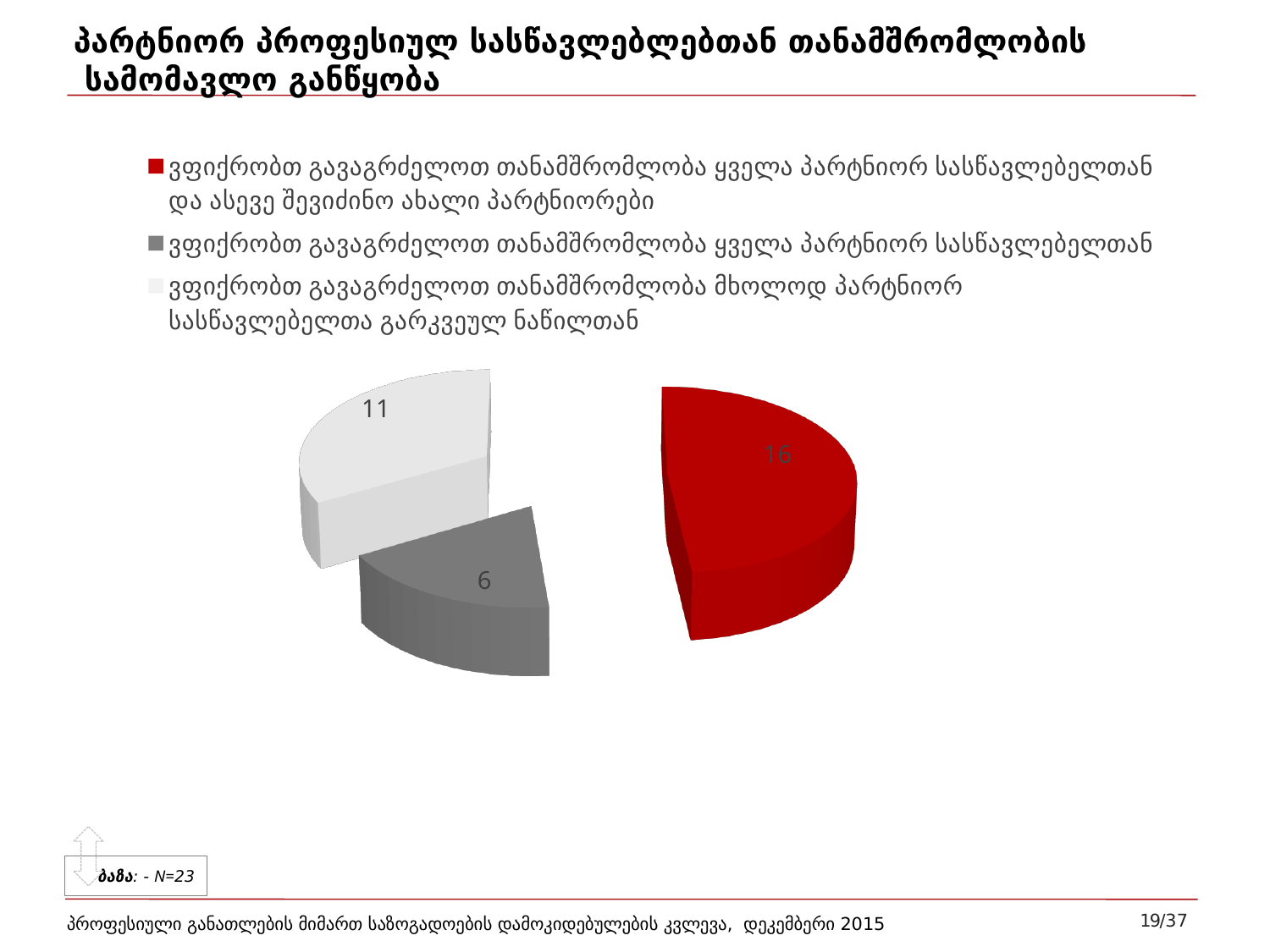
What is the difference between the red slice (16) and the light grey slice (11)? 5 What is the difference between the light grey slice (11) and the dark grey slice (6)? 5 Which slice of the pie chart has the smallest value? ვფიქრობთ გავაგრძელოთ თანამშრომლობა ყველა პარტნიორ სასწავლებელთან (6) How many slices does the pie chart have? 3 What is the value of the light grey slice (ვფიქრობთ გავაგრძელოთ თანამშრომლობა მხოლოდ პარტნიორ სასწავლებელთა გარკვეულ ნაწილთან)? 11 What is the value of the dark grey slice (ვფიქრობთ გავაგრძელოთ თანამშრომლობა ყველა პარტნიორ სასწავლებელთან)? 6 What colour is the slice with the value 16? red Which is larger: the light grey slice or the dark grey slice? the light grey slice (11) How many entries does the legend of the pie chart list? 3 What is the value of the red slice (ვფიქრობთ გავაგრძელოთ თანამშრომლობა ყველა პარტნიორ სასწავლებელთან და ასევე შევიძინო ახალი პარტნიორები)? 16 What type of chart is shown on the slide? pie chart Which slice of the pie chart has the largest value? ვფიქრობთ გავაგრძელოთ თანამშრომლობა ყველა პარტნიორ სასწავლებელთან და ასევე შევიძინო ახალი პარტნიორები (16)